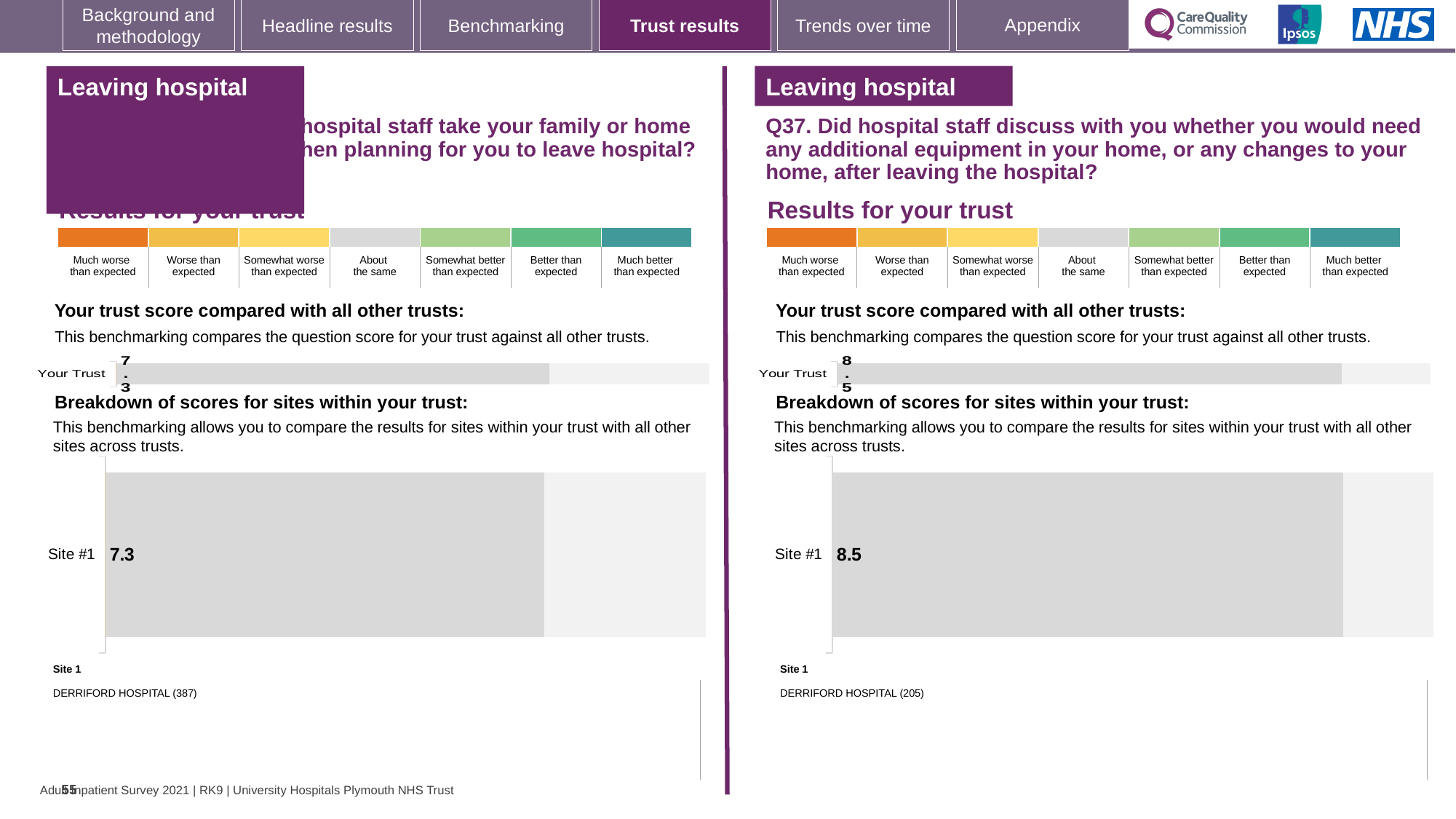
On the left-hand 'Your trust score compared with all other trusts' chart, what is the score for Your Trust? 7.3 What kind of chart is used to show the Site #1 score on the right-hand side of the slide? Bar chart On the right-hand 'Breakdown of scores for sites within your trust' chart (Q37), what is the score for Site #1? 8.5 Which Site #1 score is larger: the one on the left-hand chart or the one on the right-hand Q37 chart? The right-hand Q37 chart On the right-hand chart for Q37, what is the score shown for Your Trust? 8.5 What is the difference between the Site #1 score on the right-hand Q37 chart and the Site #1 score on the left-hand chart? 1.2 What number appears in brackets after DERRIFORD HOSPITAL below the left-hand breakdown chart? 387 How many sites are shown in the right-hand 'Breakdown of scores for sites within your trust' chart? 1 On the left-hand 'Breakdown of scores for sites within your trust' chart, what is the score for Site #1? 7.3 Which hospital is listed as Site 1 below the right-hand breakdown chart? DERRIFORD HOSPITAL